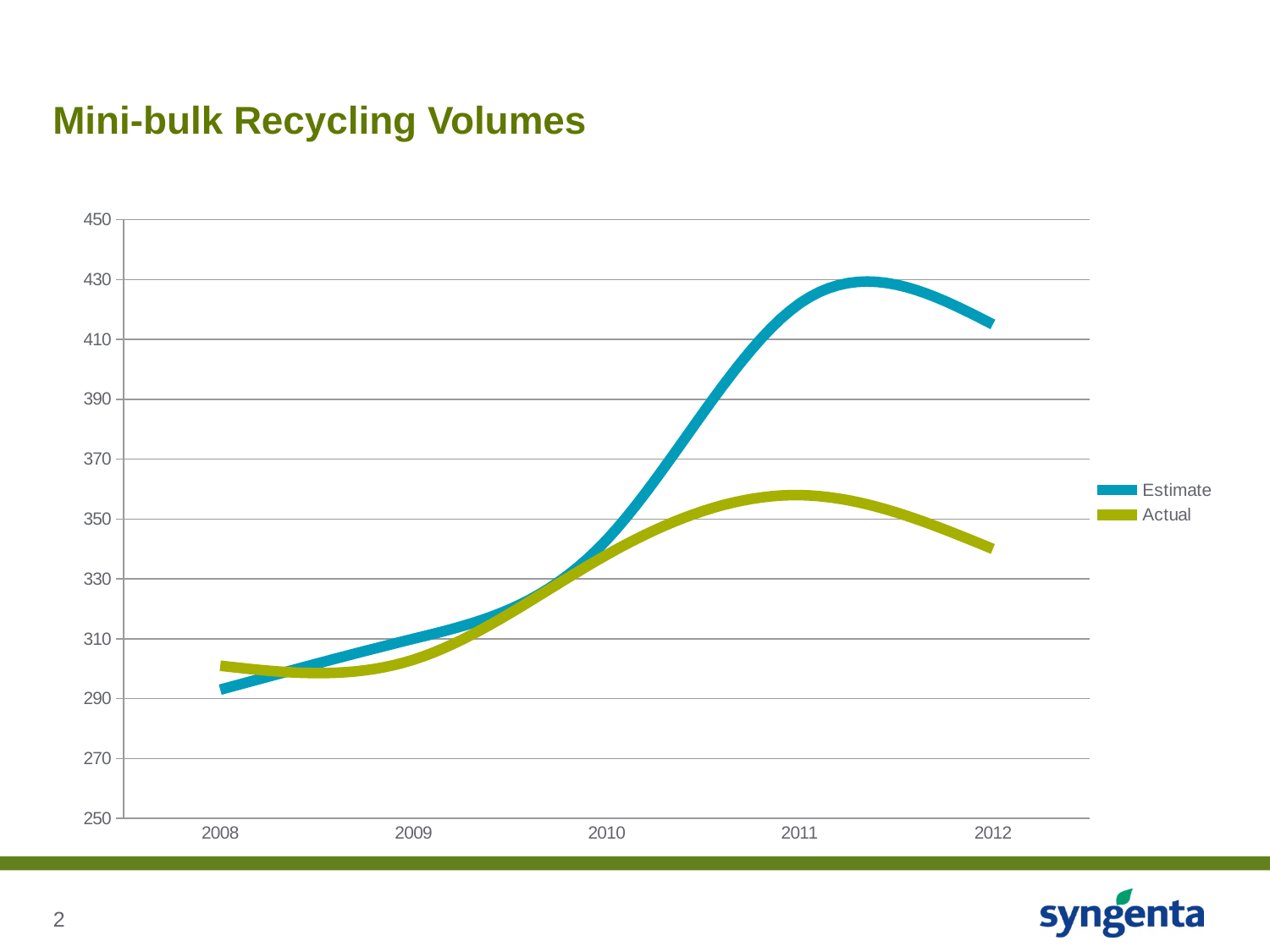
Which series is drawn in green? Actual Is the Actual value for 2011 greater or less than 370? less Is the Estimate value for 2011 greater or less than 410? greater How many years are shown on the x axis? 5 In which year does the Actual series reach its highest value? 2011 In 2012, which series has the larger value, Estimate or Actual? Estimate What is the title of the chart? Mini-bulk Recycling Volumes Does the Estimate series rise or fall from 2008 to 2011? Rise How many series does the legend list? 2 In which year is the Estimate series at its lowest value? 2008 What type of chart is shown on the slide? Line chart In which year does the Estimate series reach its highest value? 2011